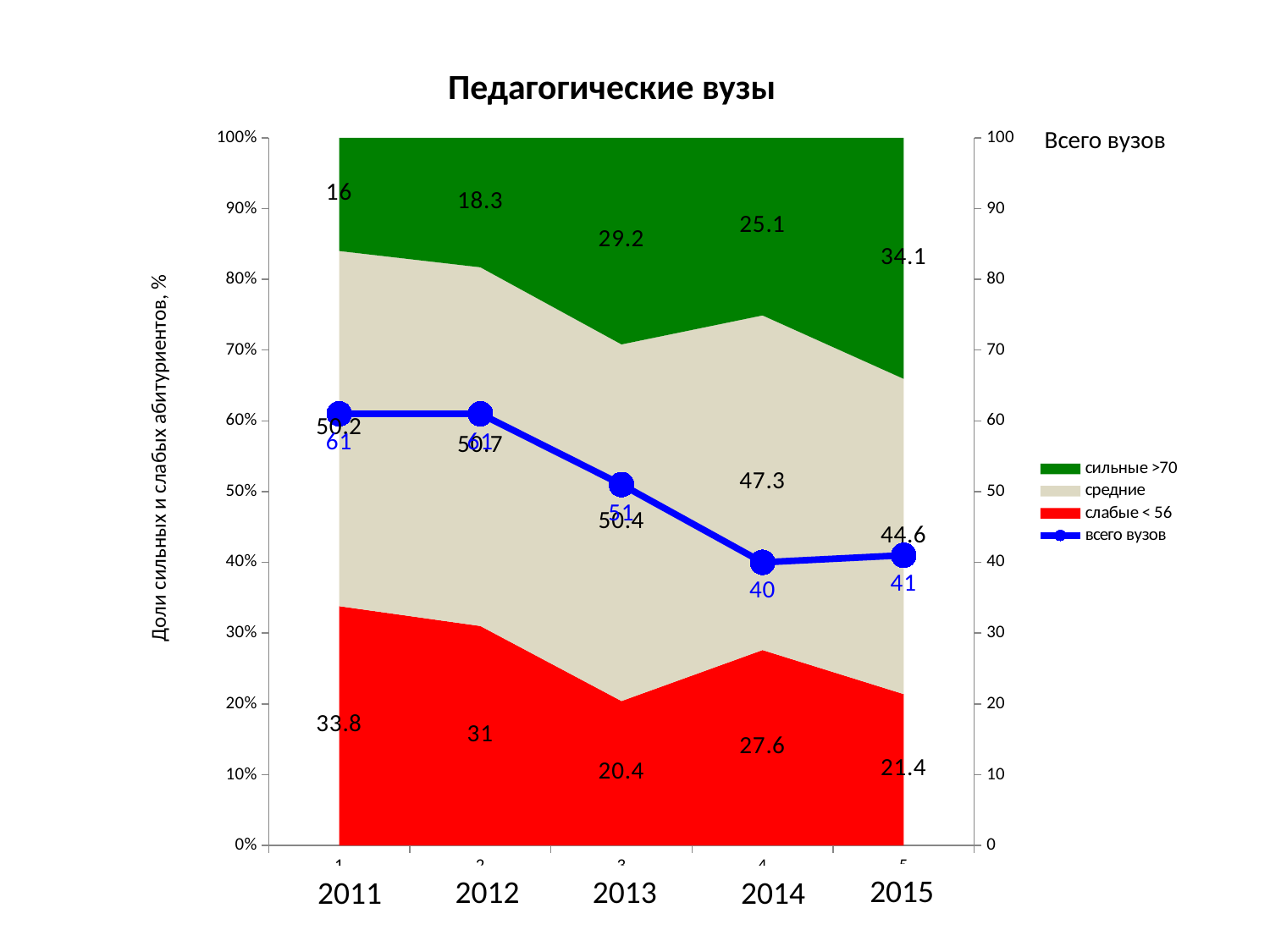
Which is larger in 2014: the value for сильные >70 or the value for слабые < 56? слабые < 56 Does the всего вузов line generally rise or fall from 2011 to 2015? fall How many years are shown on the x axis? 5 What is the value for сильные >70 in 2015? 34.1 How many series does the legend list? 4 In which year is the value for сильные >70 the highest? 2015 What is the value for слабые < 56 in 2013? 20.4 In which year is the value for слабые < 56 the lowest? 2013 What is the value of всего вузов in 2014? 40 What is the value for средние in 2012? 50.7 What is the title of the chart? Педагогические вузы What is the difference between the слабые < 56 values in 2011 and 2015? 12.4